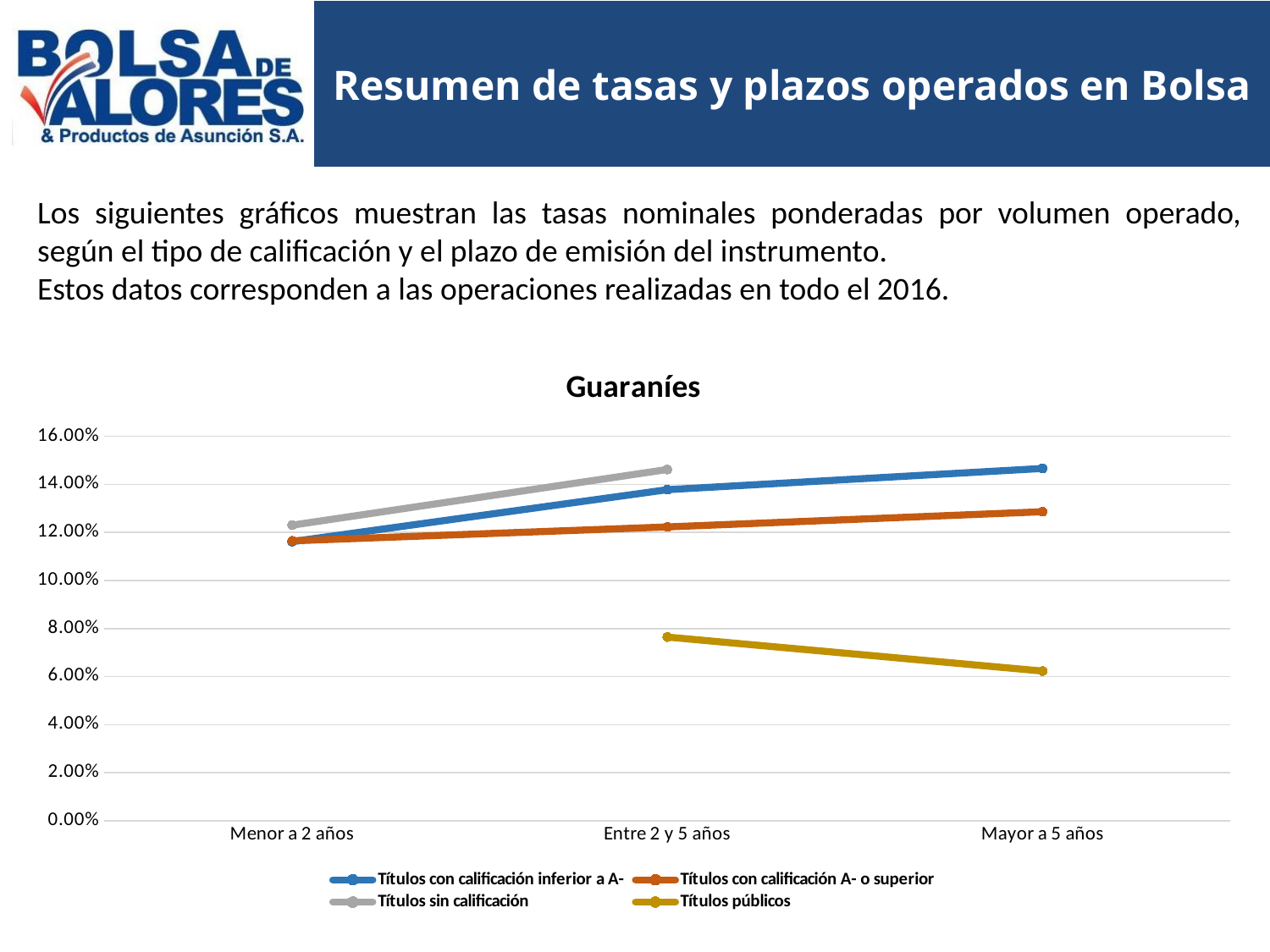
Is the value for Títulos públicos at Entre 2 y 5 años greater or less than 8.00%? less Is the value for Títulos sin calificación at Entre 2 y 5 años greater or less than 14.00%? greater Is the value for Títulos con calificación inferior a A- at Mayor a 5 años greater or less than 14.00%? greater Does the Títulos con calificación A- o superior series rise or fall across the x axis? Rise Does the Títulos públicos series rise or fall from Entre 2 y 5 años to Mayor a 5 años? Fall How many categories are shown on the x axis? 3 What is the title of the chart? Guaraníes What kind of chart is shown on the slide? Line chart How many series does the legend list? 4 At Entre 2 y 5 años, which is larger: Títulos públicos or Títulos con calificación A- o superior? Títulos con calificación A- o superior At Mayor a 5 años, which is larger: Títulos con calificación inferior a A- or Títulos con calificación A- o superior? Títulos con calificación inferior a A-